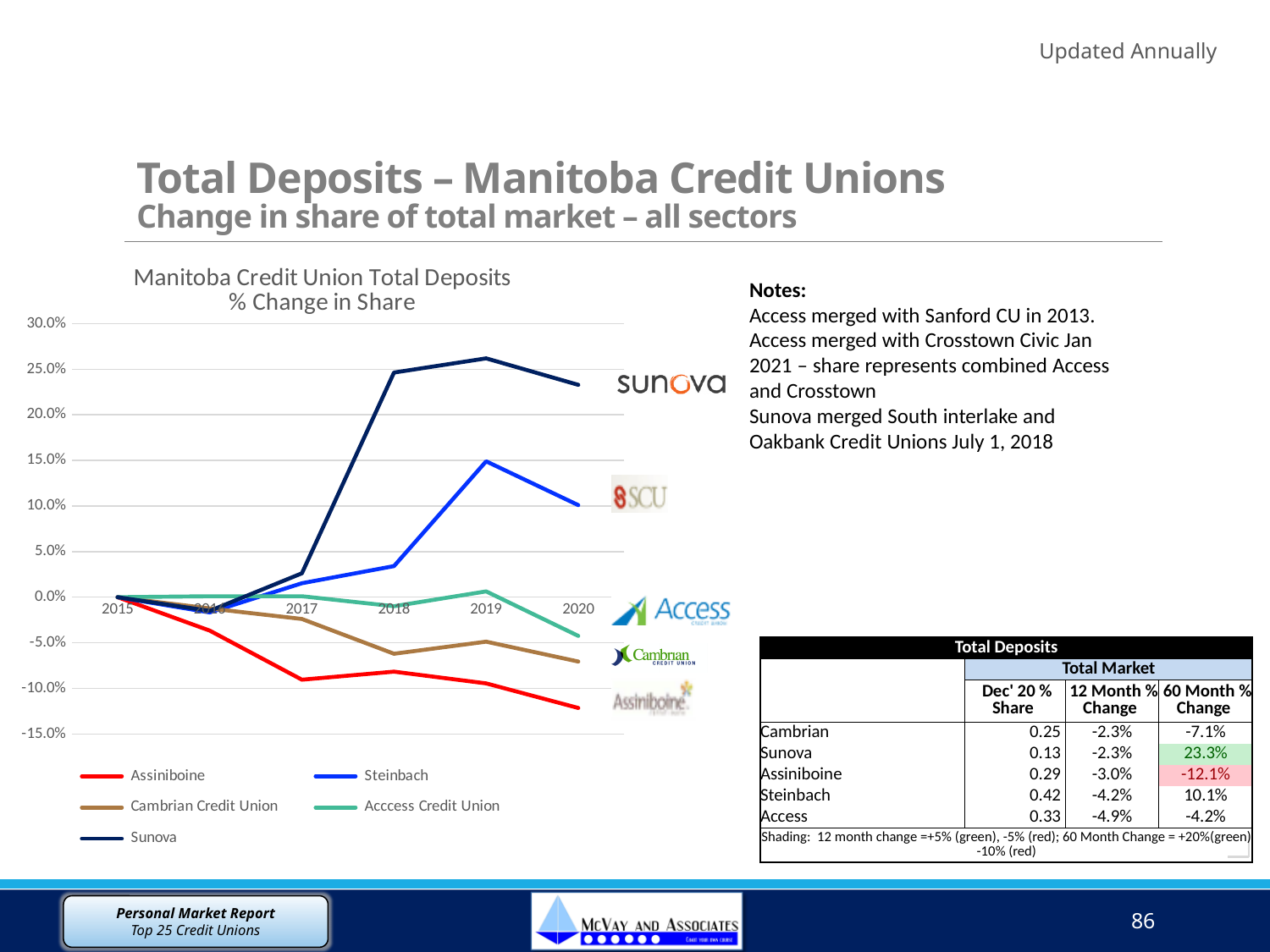
Which credit union has the lowest % change in share in 2020? Assiniboine What kind of chart is shown on the slide? line chart In 2018, which is higher: Sunova or Steinbach? Sunova Is the value for Assiniboine in 2020 greater or less than -10.0%? less What is the title of the chart? Manitoba Credit Union Total Deposits % Change in Share How many years are shown along the x axis of the chart? 6 What colour is the Assiniboine line in the chart? red Does the Assiniboine line rise or fall from 2015 to 2020? fall Is the value for Steinbach in 2019 greater or less than 10.0%? greater How many series does the legend of the chart list? 5 Is the value for Sunova in 2019 greater or less than 20.0%? greater Which credit union has the highest % change in share in 2020? Sunova